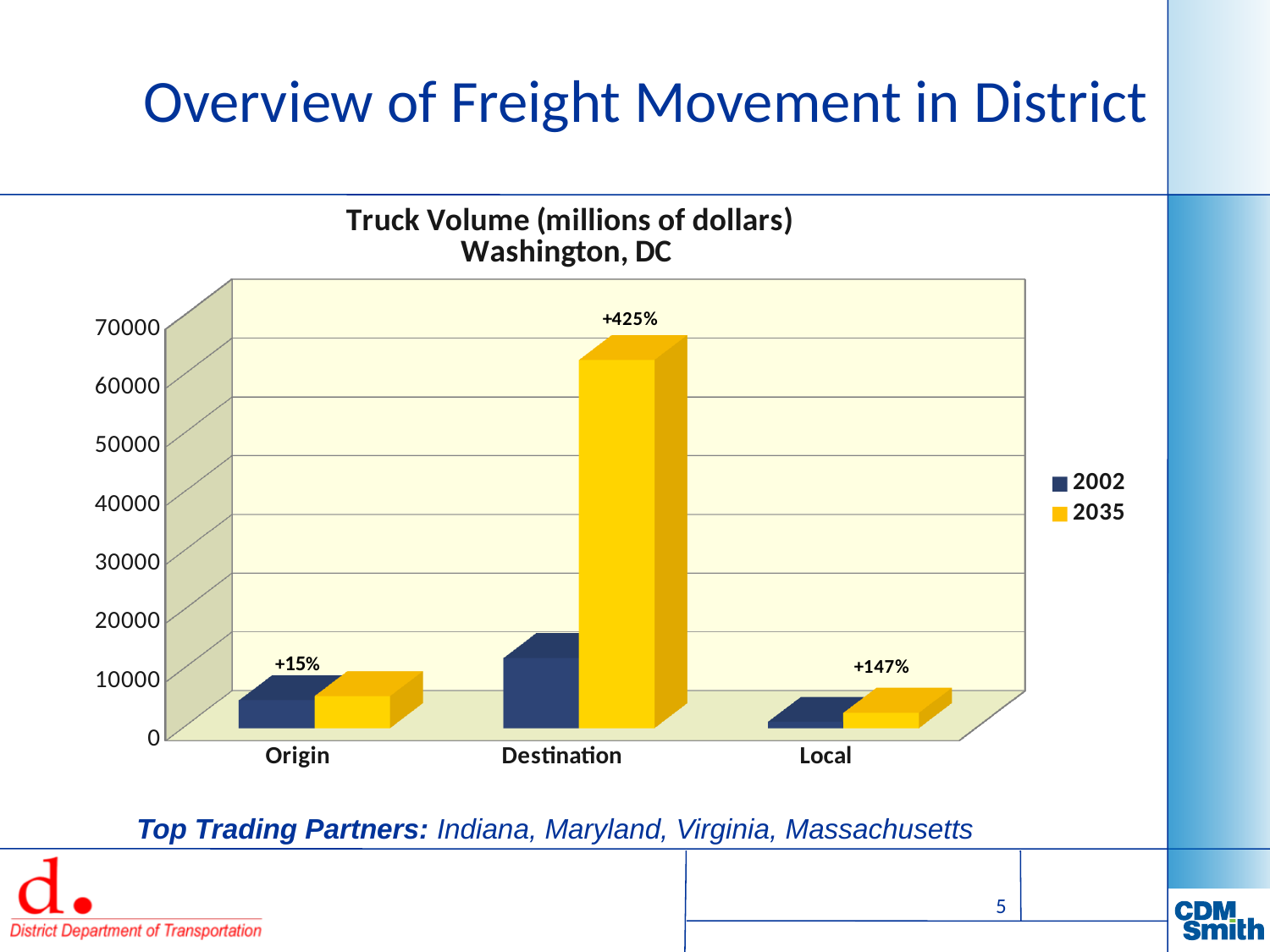
What kind of chart is shown on the slide? bar chart How many series does the legend of the Truck Volume chart list? 2 Which is larger, the 2035 value for Destination or the 2035 value for Local? Destination Which category has the lowest 2002 truck volume? Local Is the 2035 value for Origin greater or less than 10000? less Which category has the highest 2035 truck volume? Destination How many categories are shown on the x axis of the Truck Volume chart? 3 Is the 2035 value for Destination greater or less than 50000? greater What percentage change is labelled above the Destination bars? +425% What are the two years listed in the legend of the Truck Volume chart? 2002 and 2035 What percentage change is labelled above the Local bars? +147% What percentage change is labelled above the Origin bars? +15%